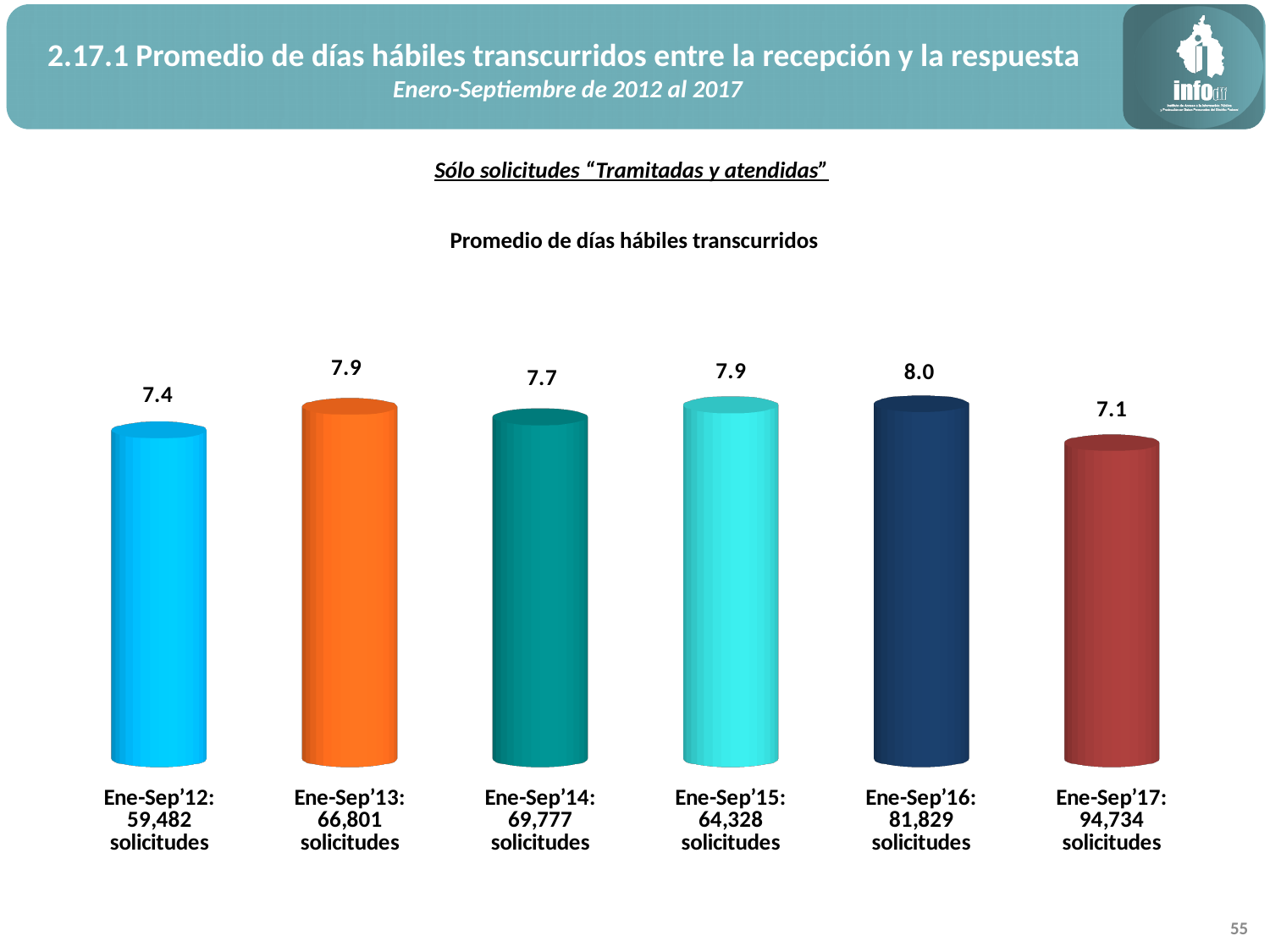
How many solicitudes are listed for Ene-Sep'17? 94,734 solicitudes What is the title of the chart? Promedio de días hábiles transcurridos What is the average number of business days for Ene-Sep'16? 8.0 Which period has the lowest average number of business days? Ene-Sep'17 What is the difference between the values for Ene-Sep'16 and Ene-Sep'17? 0.9 Which period has the highest average number of business days? Ene-Sep'16 What is the average number of business days for Ene-Sep'12? 7.4 What is the difference between the values for Ene-Sep'13 and Ene-Sep'12? 0.5 How many periods are shown in the chart? 6 What is the average number of business days for Ene-Sep'17? 7.1 Which is larger, the value for Ene-Sep'14 or the value for Ene-Sep'15? Ene-Sep'15 What kind of chart is shown on the slide? Bar chart